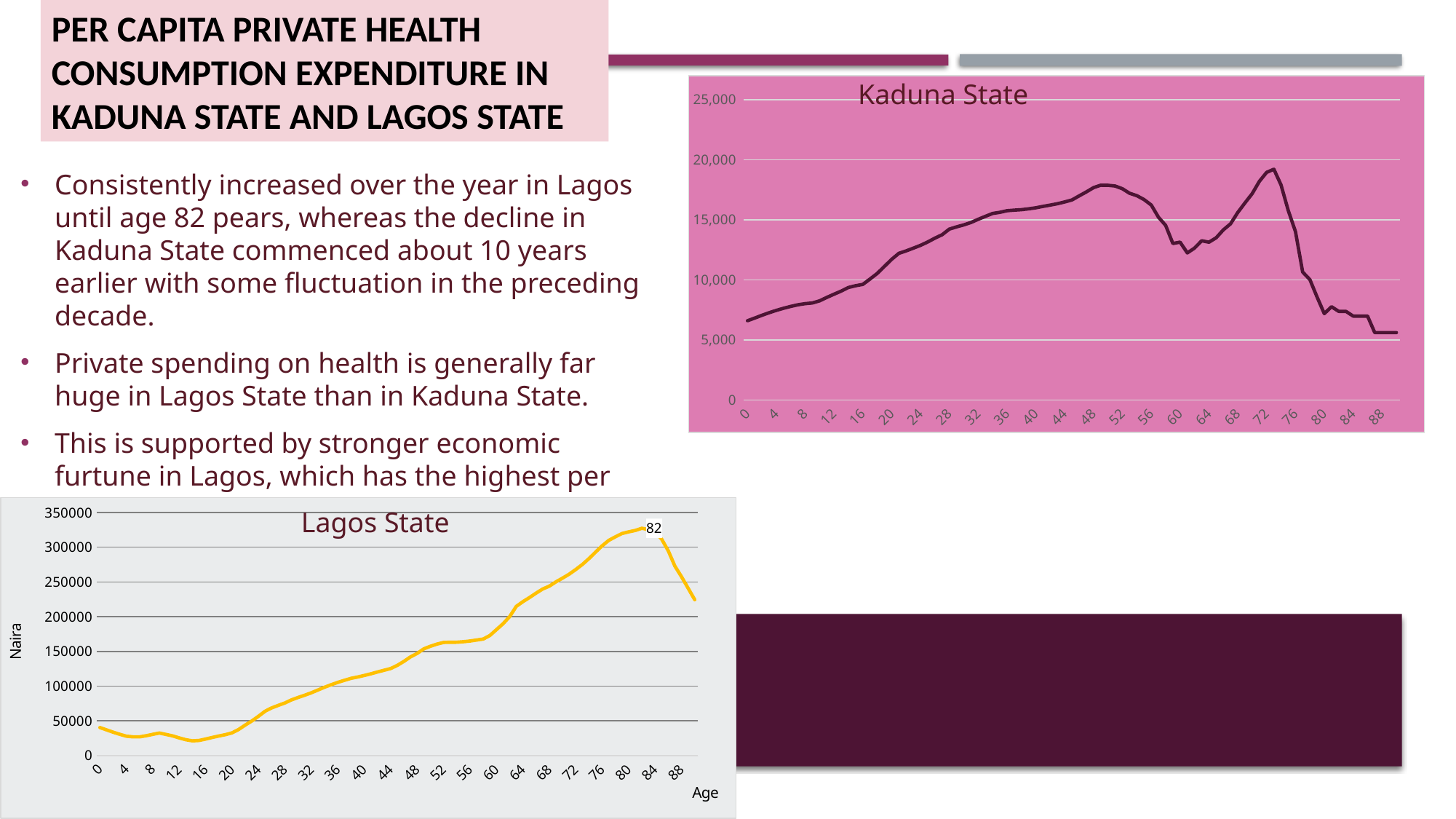
In the Kaduna State chart, is the value at age 0 greater or less than 10,000? less What kind of chart is the Lagos State chart? line chart In the Lagos State chart, is the value at age 16 greater or less than 50000? less In the Kaduna State chart, do the values rise or fall between age 72 and age 88? fall In the Lagos State chart, do the values rise or fall between age 20 and age 82? rise In the Kaduna State chart, do the values rise or fall between age 0 and age 48? rise In the Kaduna State chart, is the peak value around age 72 greater or less than 20,000? less What is the y-axis label on the Lagos State chart? Naira What kind of chart is the Kaduna State chart? line chart